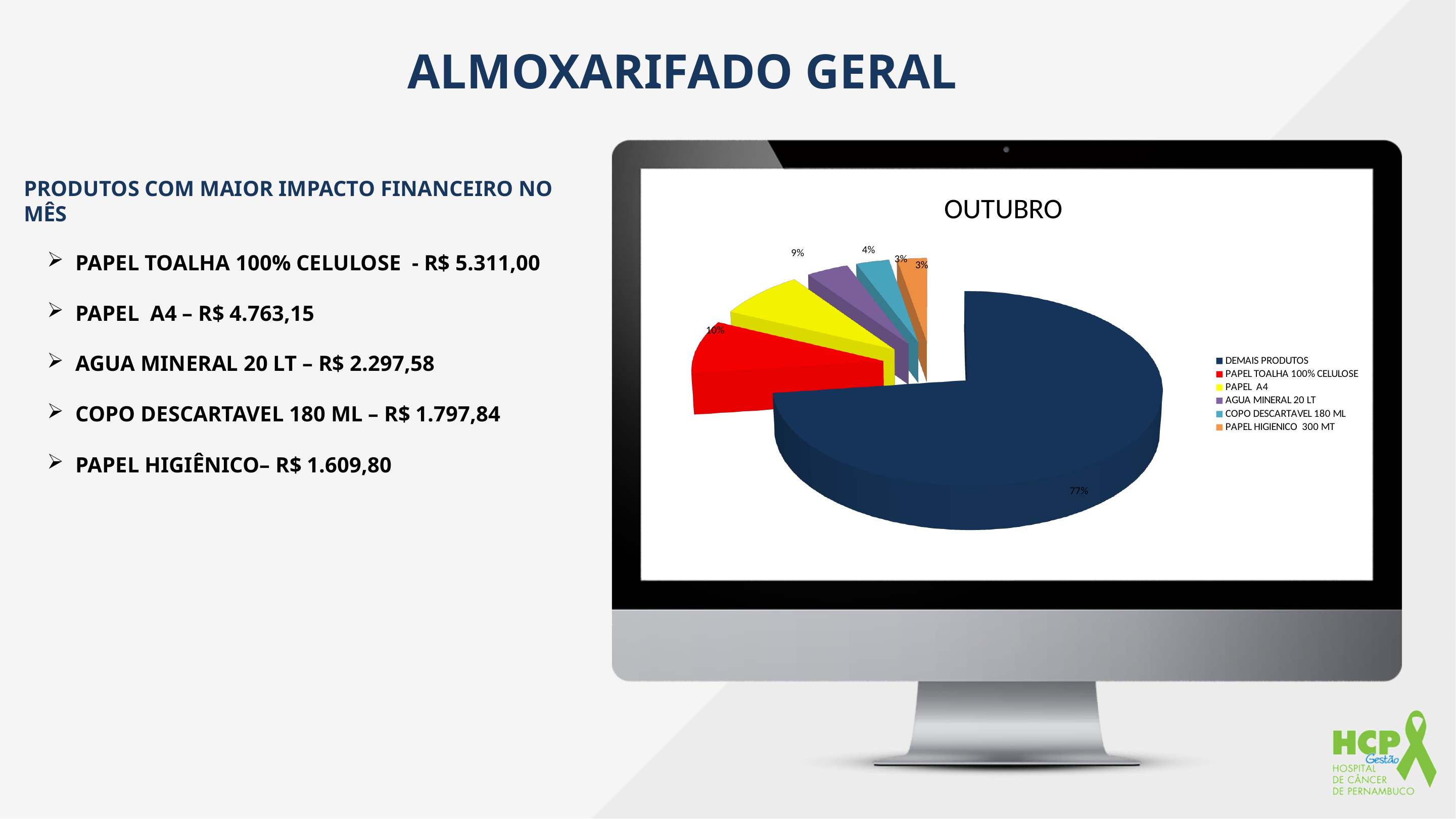
Which slice is larger, PAPEL A4 or AGUA MINERAL 20 LT? PAPEL A4 What percentage is shown for COPO DESCARTAVEL 180 ML? 3% Which colour represents PAPEL HIGIENICO 300 MT in the legend? orange What percentage is shown for PAPEL TOALHA 100% CELULOSE? 10% What is the title of the chart? OUTUBRO How many categories does the pie chart's legend list? 6 What is the difference in percentage points between DEMAIS PRODUTOS and PAPEL TOALHA 100% CELULOSE? 67 What kind of chart is shown on the slide? pie chart Which category has the largest slice of the pie? DEMAIS PRODUTOS What percentage is shown for AGUA MINERAL 20 LT? 4% What share of the pie does DEMAIS PRODUTOS represent? 77% What percentage is shown for PAPEL A4? 9%